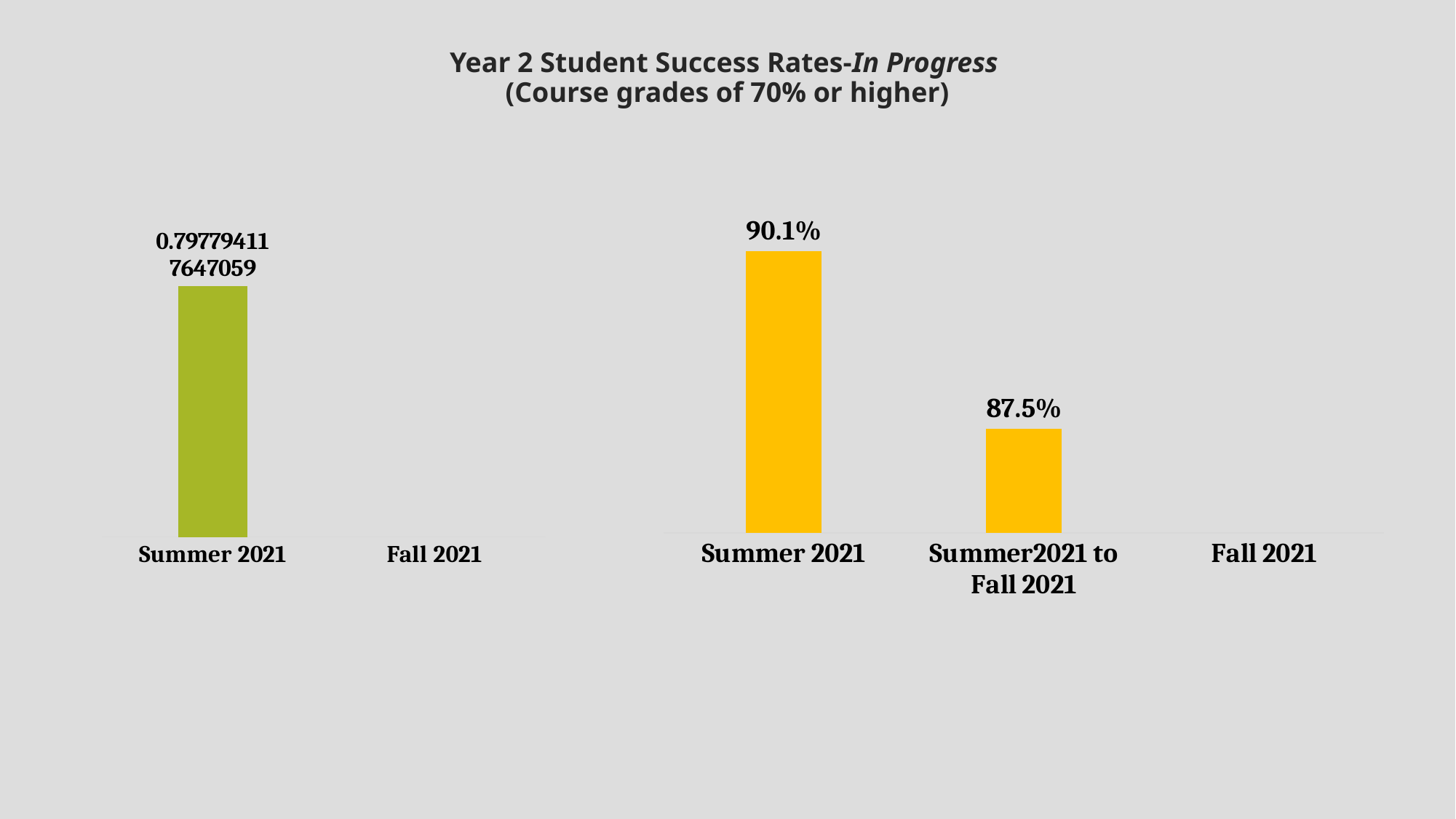
What type of chart is the left-hand chart? Bar chart In the right-hand chart, do the plotted values rise or fall from Summer 2021 to Summer2021 to Fall 2021? Fall In the right-hand chart, which category has the highest value? Summer 2021 How many category labels are shown on the x axis of the left-hand chart? 2 What is the title shown at the top of the slide above the charts? Year 2 Student Success Rates-In Progress (Course grades of 70% or higher) In the left-hand chart, what value is printed above the Summer 2021 bar? 0.797794117647059 In the right-hand chart, what is the difference between the Summer 2021 value and the Summer2021 to Fall 2021 value? 2.6% In the right-hand chart, what is the value for Summer 2021? 90.1% What colour are the bars in the right-hand chart? Yellow In the right-hand chart, what is the value for Summer2021 to Fall 2021? 87.5% How many category labels are shown on the x axis of the right-hand chart? 3 In the right-hand chart, which is larger: the value for Summer 2021 or the value for Summer2021 to Fall 2021? Summer 2021